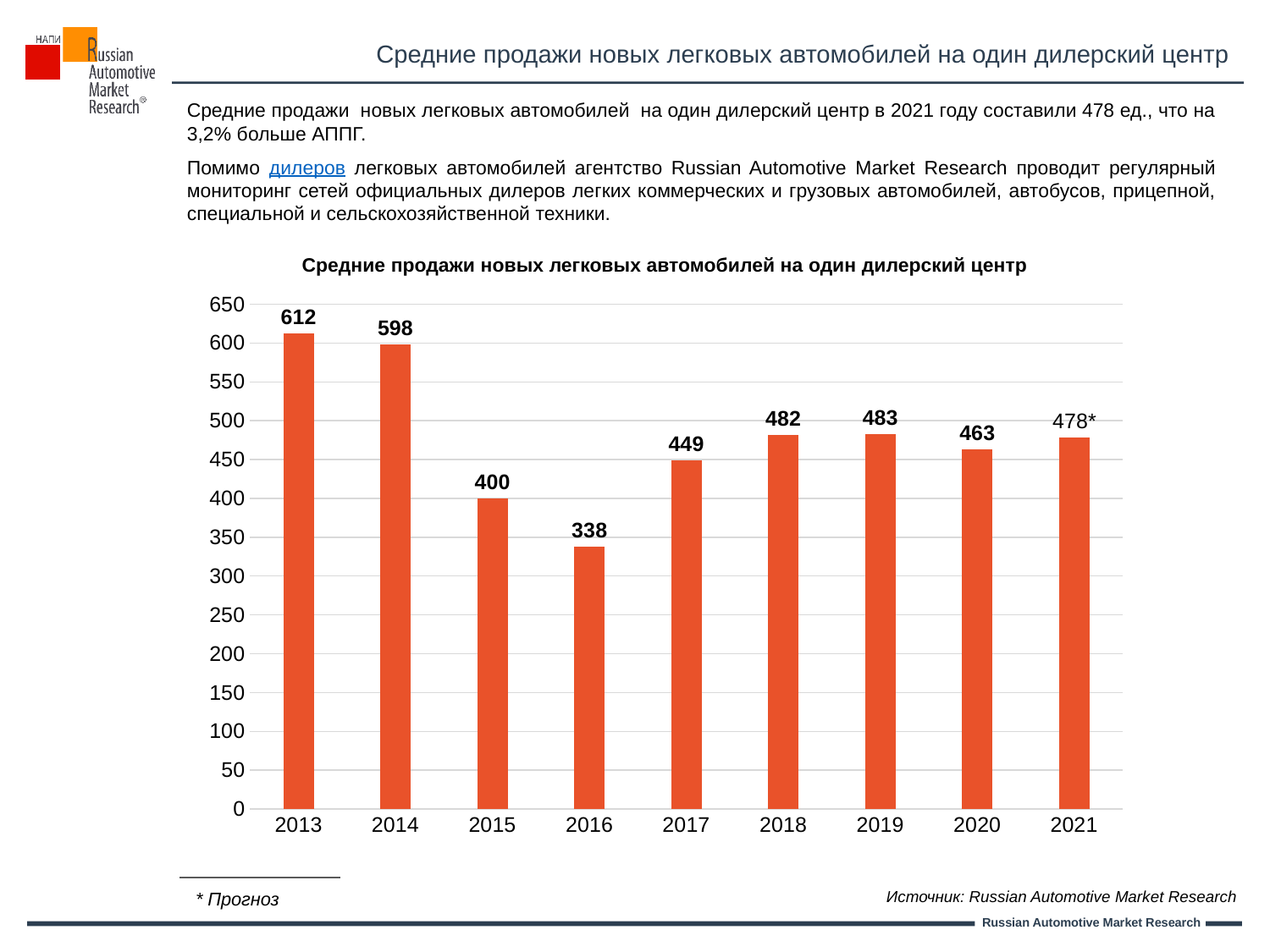
Which year has the highest average sales per dealer center? 2013 Is the value for 2018 greater or less than 450? greater What is the average sales of new passenger cars per dealer center in 2013? 612 What is the forecast value shown for 2021? 478* Which year has a larger value, 2015 or 2017? 2017 Which year has the lowest average sales per dealer center? 2016 Do the values rise or fall from 2013 to 2016? Fall What value is shown for 2016? 338 What is the difference between the values for 2013 and 2014? 14 What kind of chart is shown on the slide? Bar chart What is the difference between the values for 2020 and 2021? 15 How many years are shown on the x axis? 9